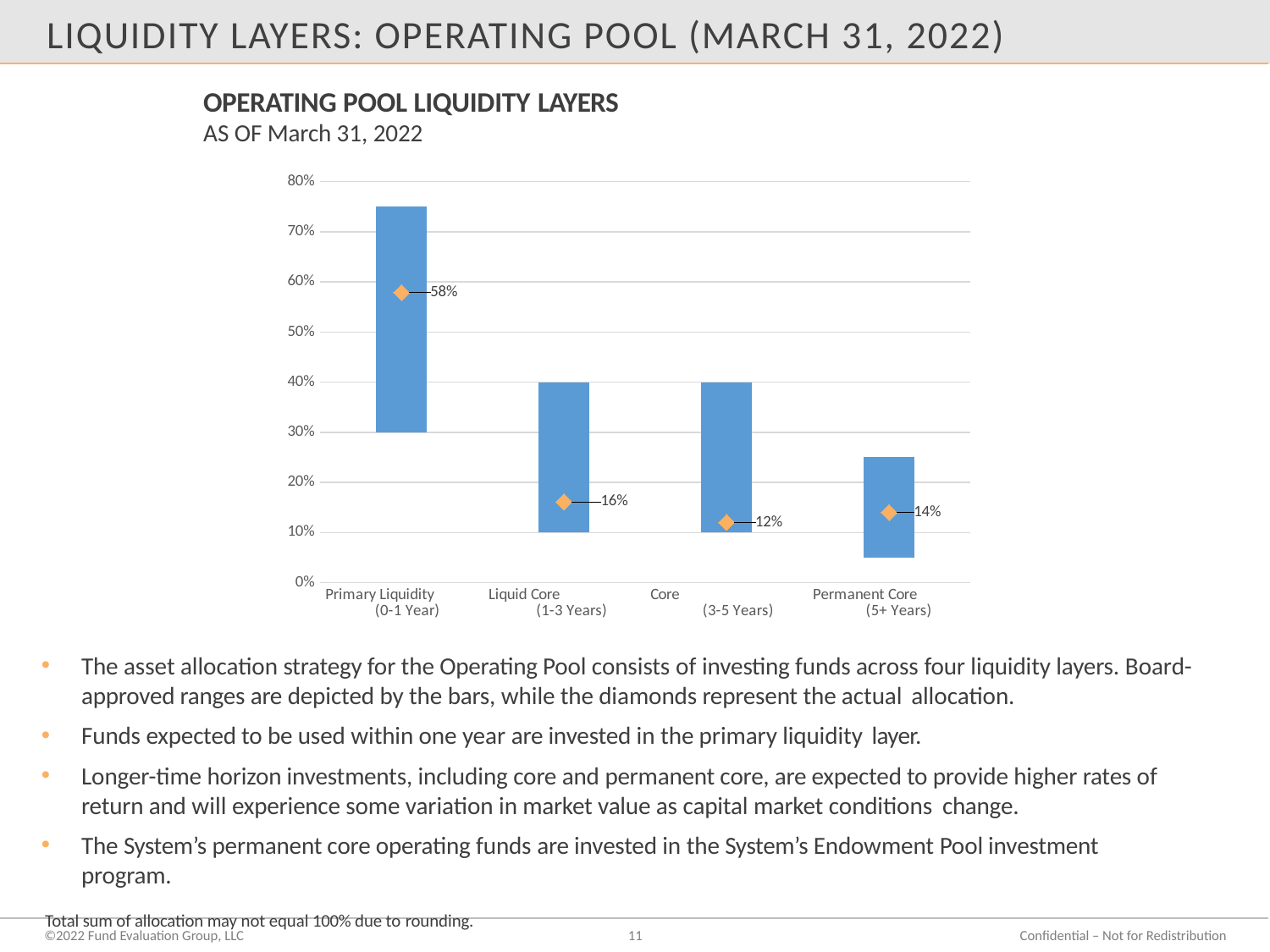
Is the bottom of the Board-approved range bar for Permanent Core greater or less than 10%? less How many percentage points higher is the actual allocation for Primary Liquidity than for Liquid Core? 42 percentage points Which liquidity layer has the highest actual allocation? Primary Liquidity (0-1 Year) What is the actual allocation (diamond) for Permanent Core (5+ Years)? 14% Is the top of the Board-approved range bar for Primary Liquidity greater or less than 70%? greater Which liquidity layer has the lowest actual allocation? Core (3-5 Years) How many liquidity layers are shown on the x axis of the chart? 4 What is the title of the chart? OPERATING POOL LIQUIDITY LAYERS What is the actual allocation (diamond) for Core (3-5 Years)? 12% What is the actual allocation (diamond) for Liquid Core (1-3 Years)? 16% Which has the larger actual allocation, Core or Permanent Core? Permanent Core What is the actual allocation (diamond) for Primary Liquidity (0-1 Year)? 58%